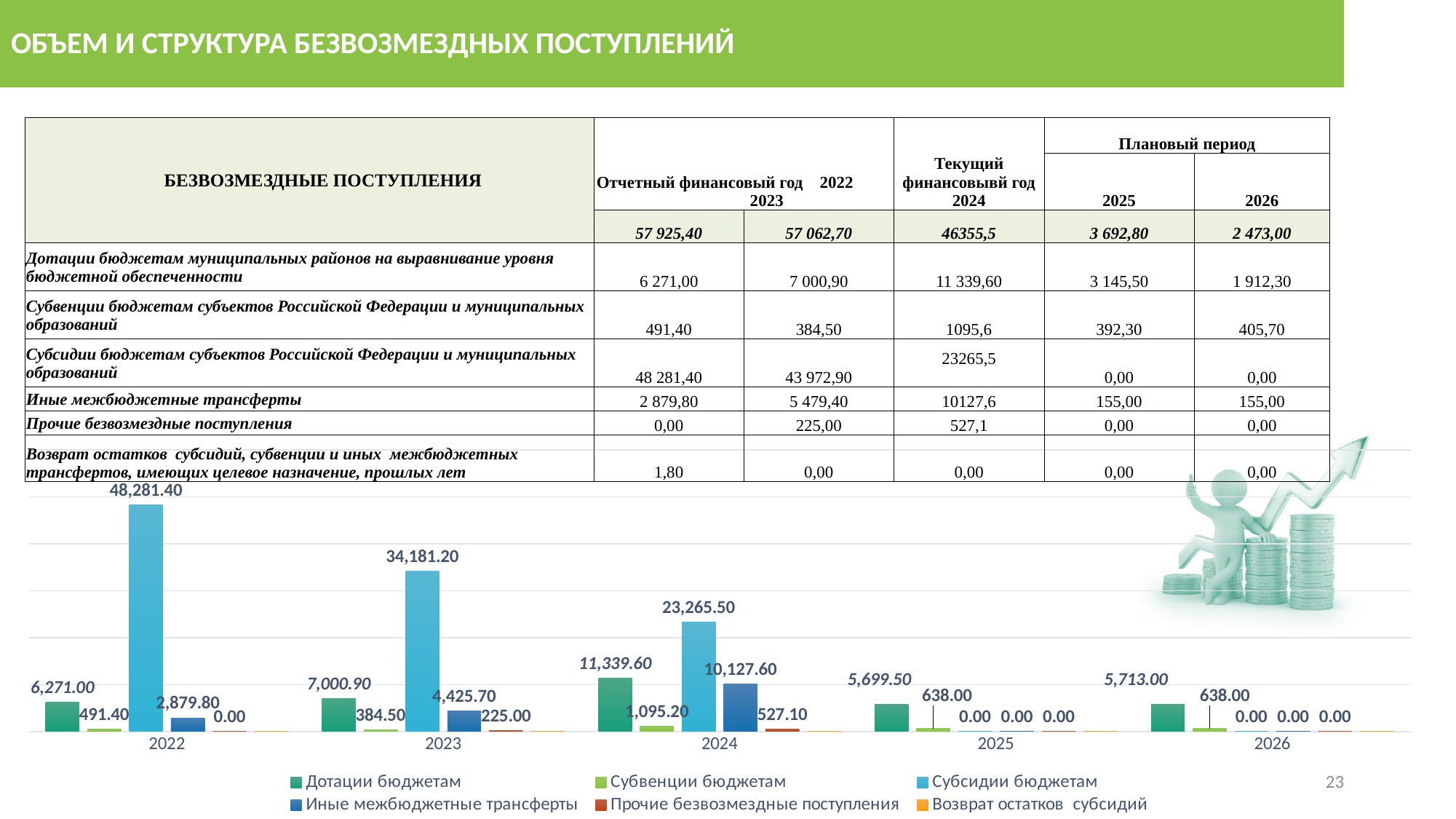
In the bar chart, which is larger in 2024: Дотации бюджетам or Иные межбюджетные трансферты? Дотации бюджетам In the bar chart, which year has the highest value for Субсидии бюджетам? 2022 How many years are shown on the x axis of the bar chart? 5 In the bar chart, what is the value for Субсидии бюджетам in 2022? 48,281.40 How many series does the legend of the bar chart list? 6 In the bar chart, what is the value for Субвенции бюджетам in 2025? 638.00 In the bar chart, what is the difference between the Субсидии бюджетам values for 2022 and 2023? 14,100.20 What kind of chart is shown at the bottom of the slide? Bar chart In the bar chart, what is the value for Дотации бюджетам in 2024? 11,339.60 In the bar chart, what is the value for Прочие безвозмездные поступления in 2023? 225.00 In the bar chart, do the values for Субсидии бюджетам rise or fall from 2022 to 2024? Fall In the bar chart, what is the difference between the Дотации бюджетам values for 2023 and 2022? 729.90